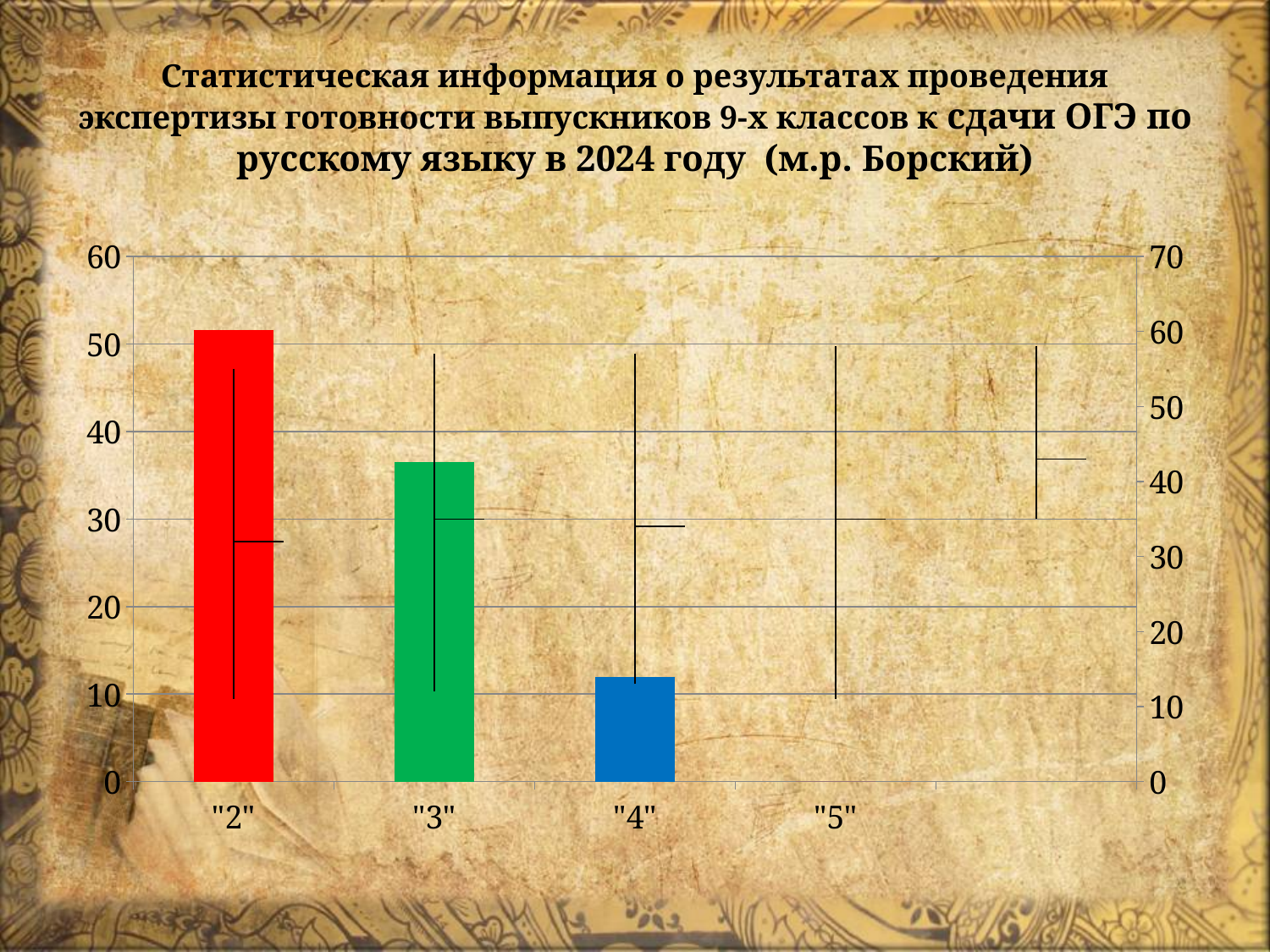
How many category labels are shown on the x axis? 4 On the left axis, is the value for "4" greater or less than 20? less What kind of chart is shown on the slide? bar chart Which bar is taller, "2" or "3"? "2" On the left axis, is the value for "3" greater or less than 40? less On the left axis, is the value for "3" greater or less than 30? greater What colour is the bar for category "2"? red Which of the categories with a visible bar has the shortest bar? "4" Which bar is taller, "3" or "4"? "3" Do the bar heights rise or fall going from "2" to "4" along the x axis? fall Which category has the tallest bar? "2"